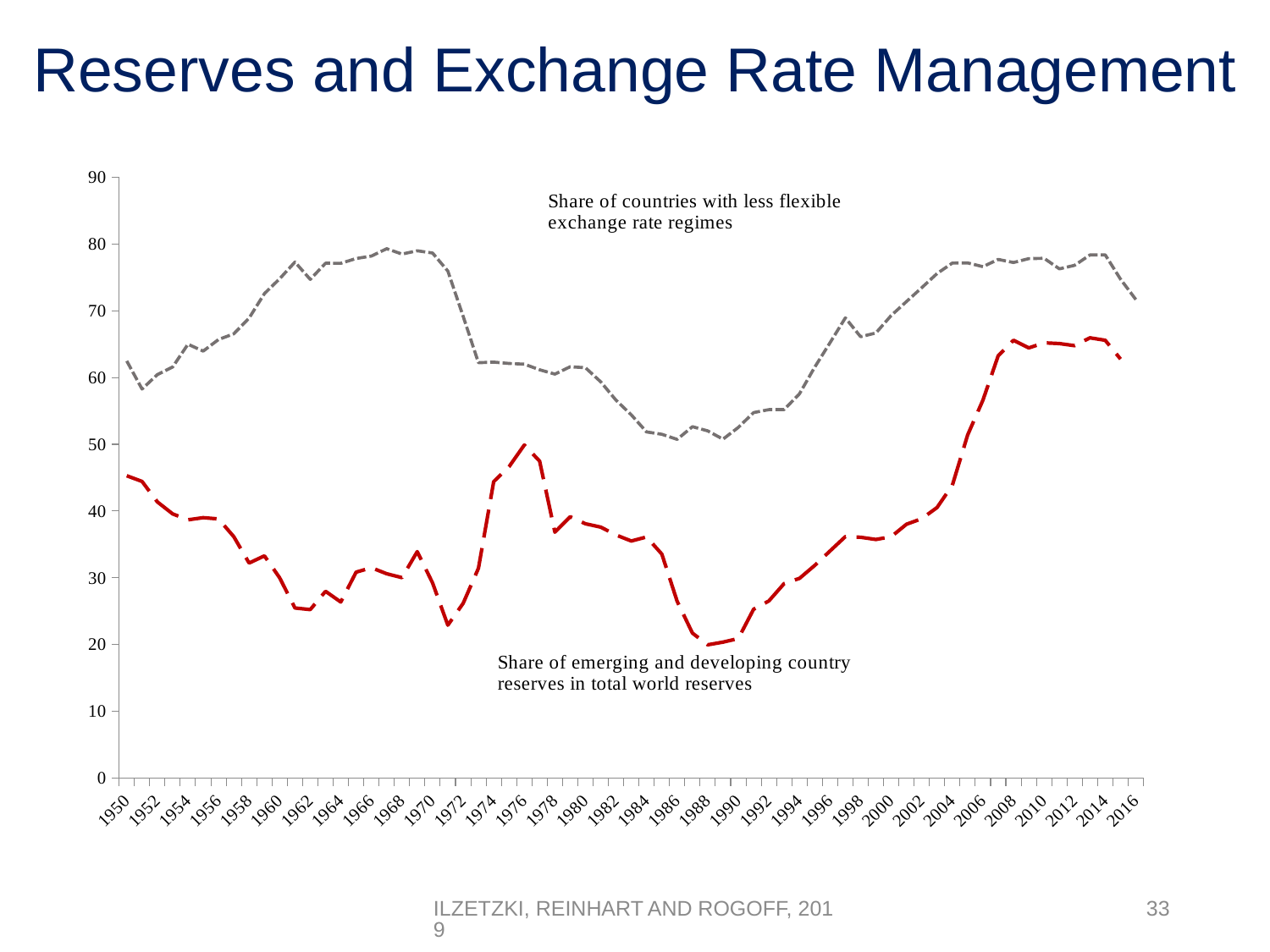
Is the value of the share of emerging and developing country reserves in total world reserves in 2008 greater or less than 60? greater What is the first year shown on the x axis of the chart? 1950 Does the share of emerging and developing country reserves in total world reserves rise or fall between 1988 and 2008? rise How many data series are plotted on the chart? 2 What kind of chart is shown on the slide? line chart What colour is the line for the share of emerging and developing country reserves in total world reserves? red In 1988, which series has the higher value: the share of countries with less flexible exchange rate regimes or the share of emerging and developing country reserves? Share of countries with less flexible exchange rate regimes Is the value of the share of emerging and developing country reserves in total world reserves in 1988 greater or less than 30? less Does the share of countries with less flexible exchange rate regimes rise or fall between 1970 and 1974? fall Is the value of the share of emerging and developing country reserves in total world reserves in 1976 greater or less than 40? greater